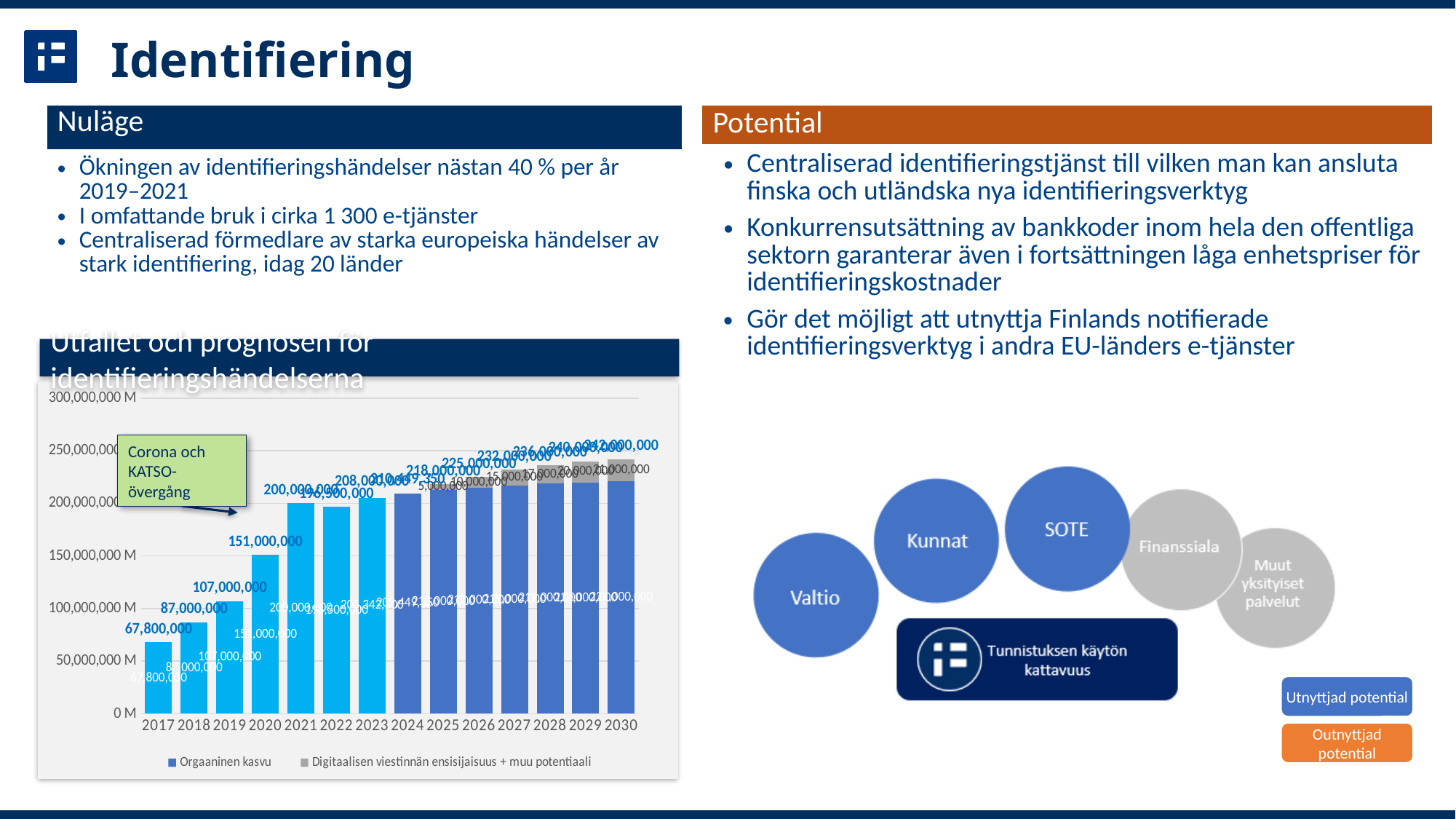
What is the value for 2021 in the chart? 200,000,000 What is the value for 2020 in the chart? 151,000,000 What is the value for 2019 in the chart? 107,000,000 Do the values rise or fall from 2017 to 2021? rise How many years are shown on the x axis of the chart? 14 What is the value for 2017 in the chart? 67,800,000 What kind of chart is shown under the title 'Utfallet och prognosen för identifieringshändelserna'? Bar chart Is the value for 2030 greater or less than 200,000,000 M? greater What is the difference between the values for 2018 and 2017? 19,200,000 What is the value for 2018 in the chart? 87,000,000 How many series does the chart's legend list? 2 Which year has the lowest value in the chart? 2017